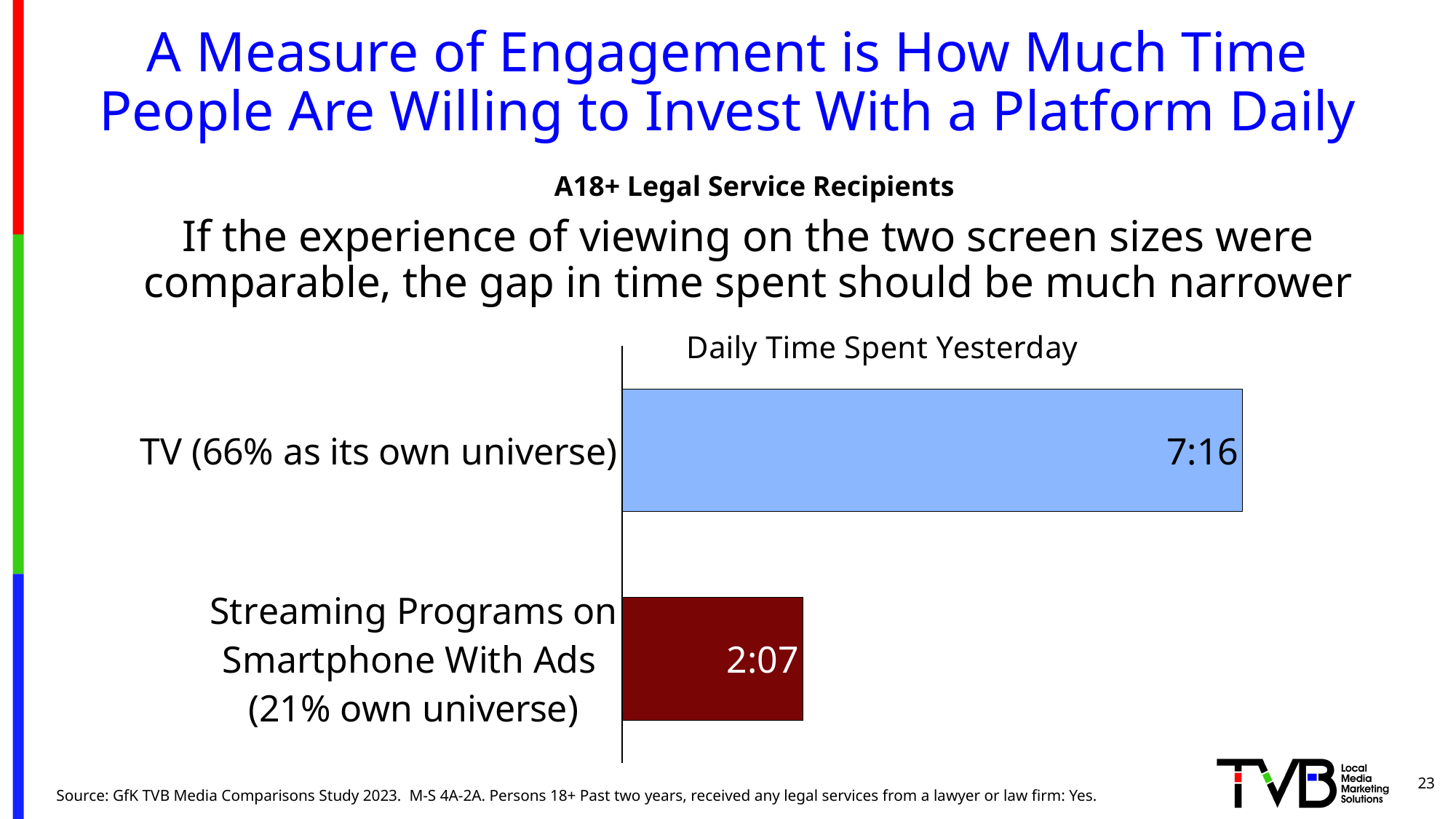
What is the daily time spent yesterday for Streaming Programs on Smartphone With Ads (21% own universe)? 2:07 What colour is the bar for Streaming Programs on Smartphone With Ads? Dark red Which category has the lowest daily time spent yesterday? Streaming Programs on Smartphone With Ads (21% own universe) How much more daily time was spent on TV than on Streaming Programs on Smartphone With Ads? 5:09 Which category has the highest daily time spent yesterday? TV (66% as its own universe) What kind of chart is shown on the slide? Bar chart Which is larger: the daily time spent on TV or on Streaming Programs on Smartphone With Ads? TV What is the title of the chart? Daily Time Spent Yesterday What is the daily time spent yesterday for TV (66% as its own universe)? 7:16 How many categories are shown in the chart? 2